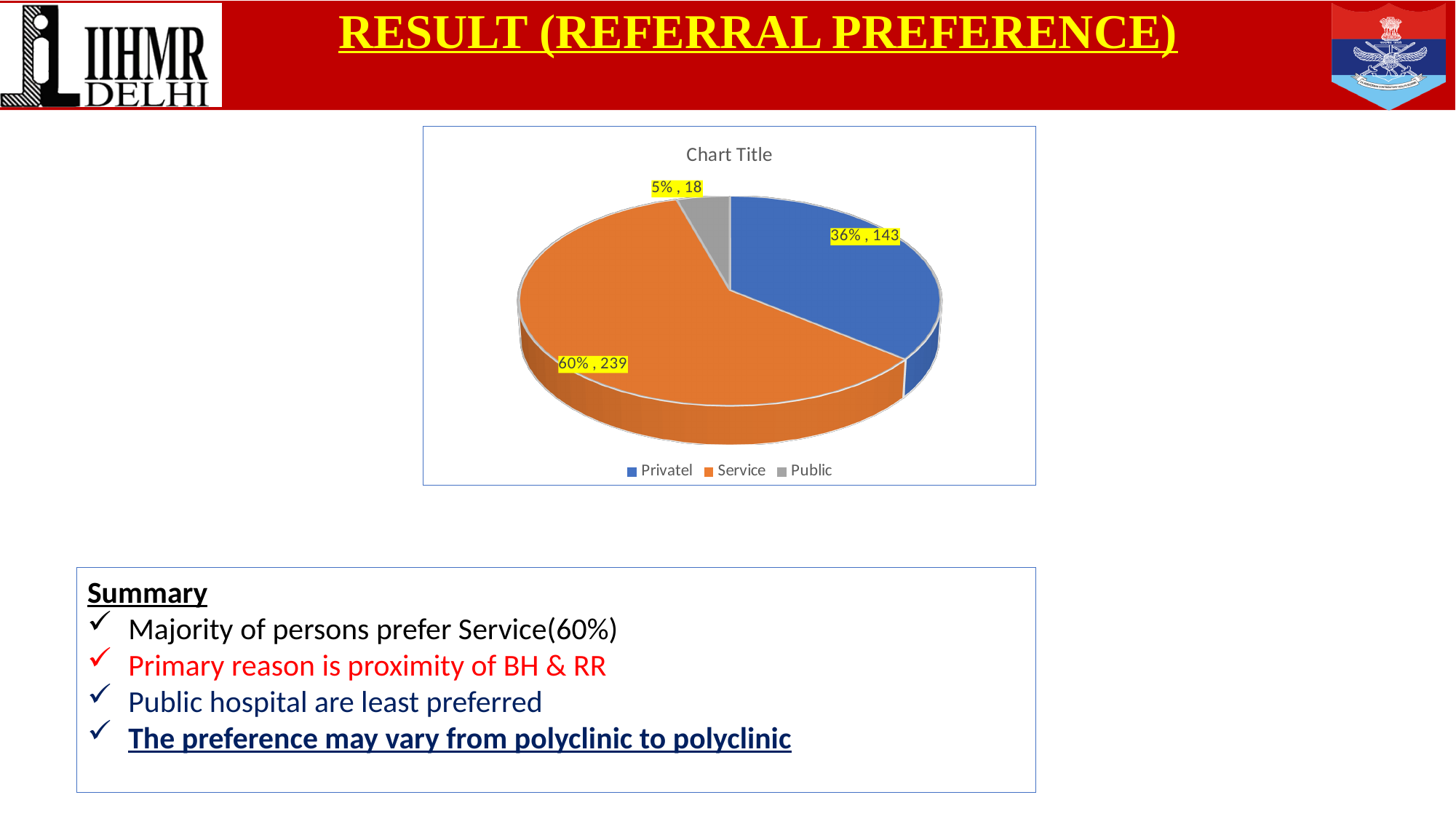
What percentage share does the Service slice have? 60% What is the count shown for the Privatel slice? 143 What percentage share does the Privatel slice have? 36% What is the difference in count between the Service and Privatel slices? 96 Which category has the smallest slice of the pie? Public What kind of chart is shown on the slide? Pie chart What is the count shown for the Service slice? 239 Which colour represents the Service slice in the pie chart? Orange Which category has the largest slice of the pie? Service What is the count shown for the Public slice? 18 What percentage share does the Public slice have? 5% How many slices does the pie chart have? 3